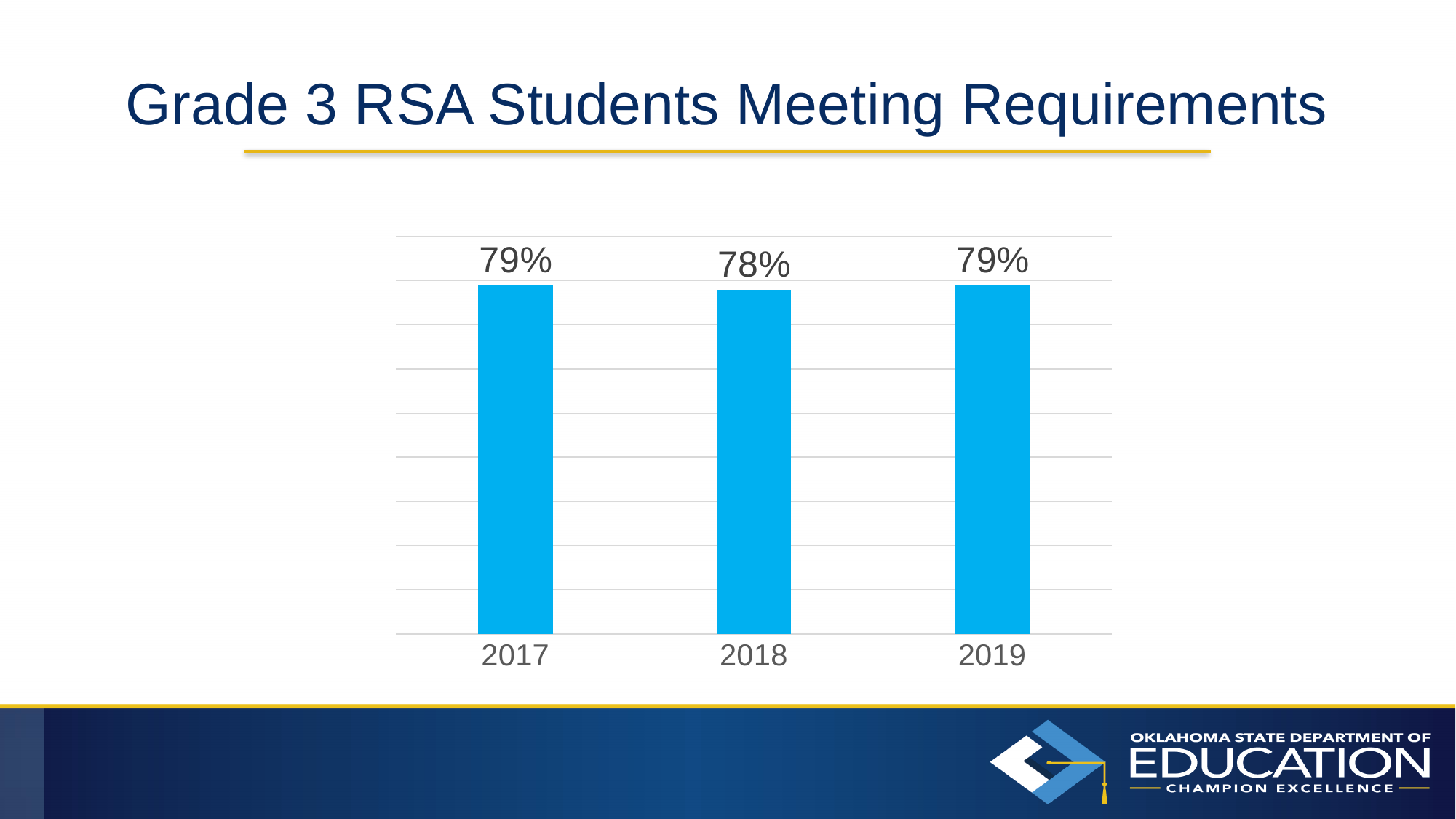
Is the value for 2019 higher or lower than the value for 2018? Higher What is the difference in percentage points between 2017 and 2018? 1 percentage point What is the title of the slide? Grade 3 RSA Students Meeting Requirements Which year has the lowest percentage of students meeting requirements? 2018 How does the percentage change from 2017 to 2019? It dips in 2018 and returns to 79% in 2019 What percentage is shown for 2019? 79% What kind of chart is shown on the slide? Bar chart How many years are shown on the chart? 3 What colour are the bars in the chart? Blue Which year has the higher value, 2017 or 2018? 2017 What is the value shown for 2018? 78% What percentage of Grade 3 RSA students met requirements in 2017? 79%